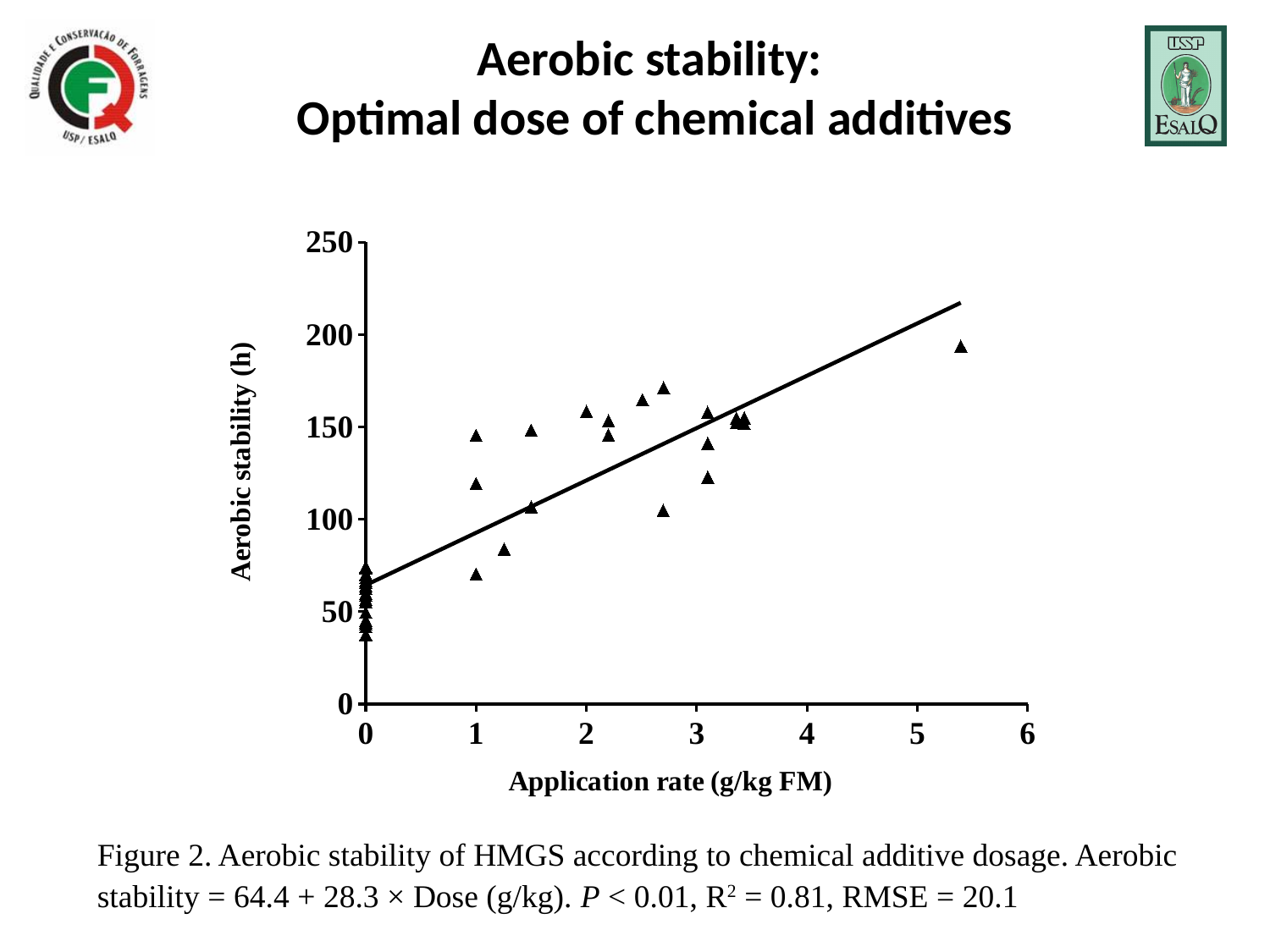
Are the aerobic stability values of the points plotted at application rate 0 greater or less than 100? less Is the application rate of the point with the highest aerobic stability greater or less than 5? greater Is the value of the fitted line at application rate 5 greater or less than 150? greater What is the label of the x axis? Application rate (g/kg FM) Which has higher aerobic stability: the point plotted beyond application rate 5 or the points plotted at application rate 0? the point beyond application rate 5 What is the label of the y axis? Aerobic stability (h) Does aerobic stability rise or fall as the application rate increases along the x axis? rise What kind of chart is shown on the slide? scatter plot